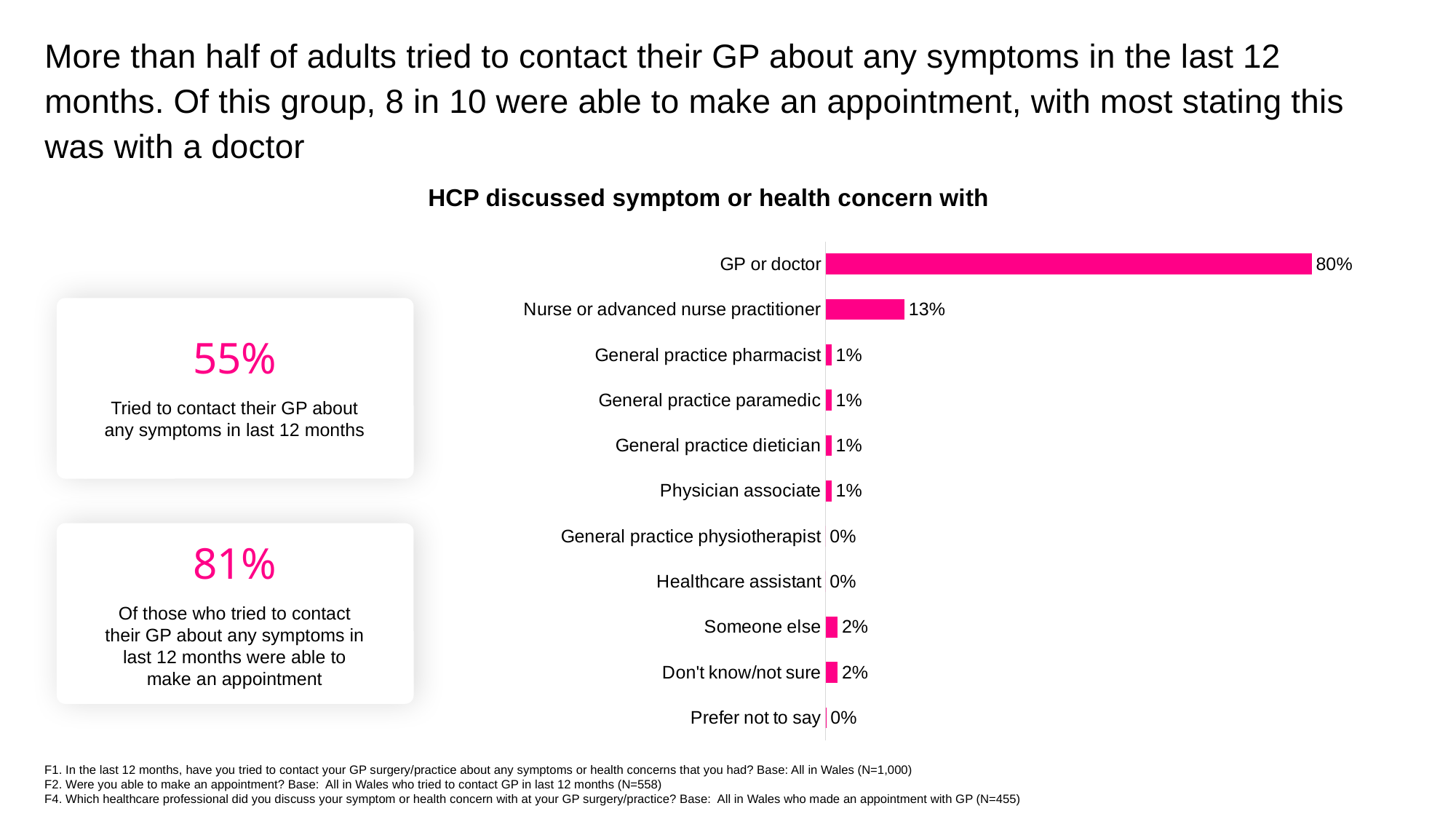
What is the difference between the values for GP or doctor and Nurse or advanced nurse practitioner? 67% What is the value for Don't know/not sure? 2% What is the value for Nurse or advanced nurse practitioner? 13% What is the title of the chart? HCP discussed symptom or health concern with What kind of chart is shown on the slide? Bar chart Which is larger, the value for Nurse or advanced nurse practitioner or the value for Someone else? Nurse or advanced nurse practitioner How many categories are shown in the chart? 11 What is the value for GP or doctor? 80% What colour are the bars in the chart? Pink Which category has the highest value? GP or doctor What is the value for General practice physiotherapist? 0% What is the value for Someone else? 2%